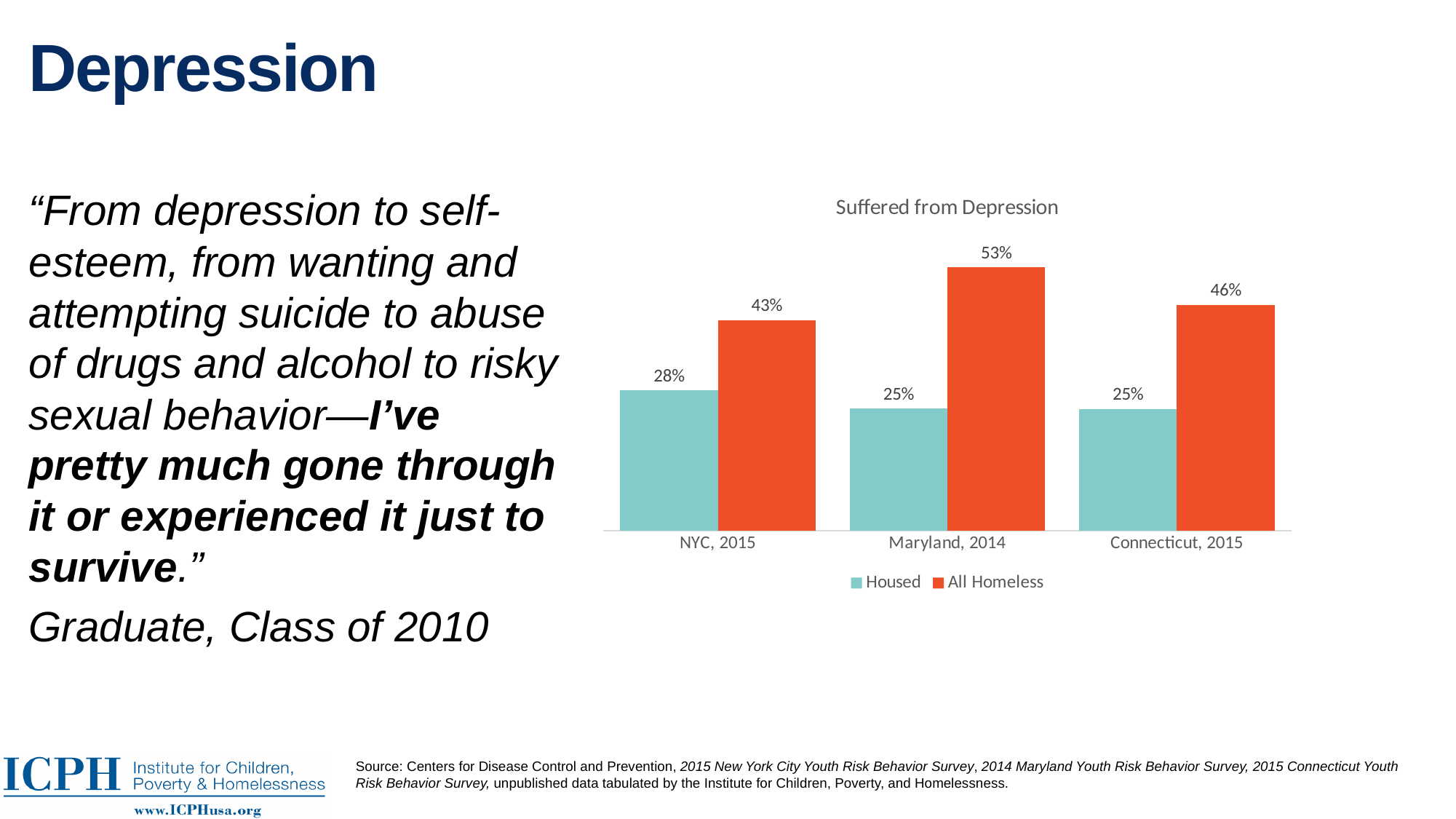
Which is larger in Connecticut, 2015: the Housed value or the All Homeless value? All Homeless What is the difference between the All Homeless and Housed values for Maryland, 2014? 28% How many series does the legend list? 2 What is the title of the chart? Suffered from Depression What is the value for All Homeless in Connecticut, 2015? 46% Which category has the highest All Homeless value? Maryland, 2014 What is the difference between the All Homeless values for Maryland, 2014 and NYC, 2015? 10% How many categories are shown on the x axis? 3 Which category has the highest Housed value? NYC, 2015 What is the value for All Homeless in Maryland, 2014? 53% What kind of chart is shown on the slide? Bar chart What is the value for Housed in NYC, 2015? 28%